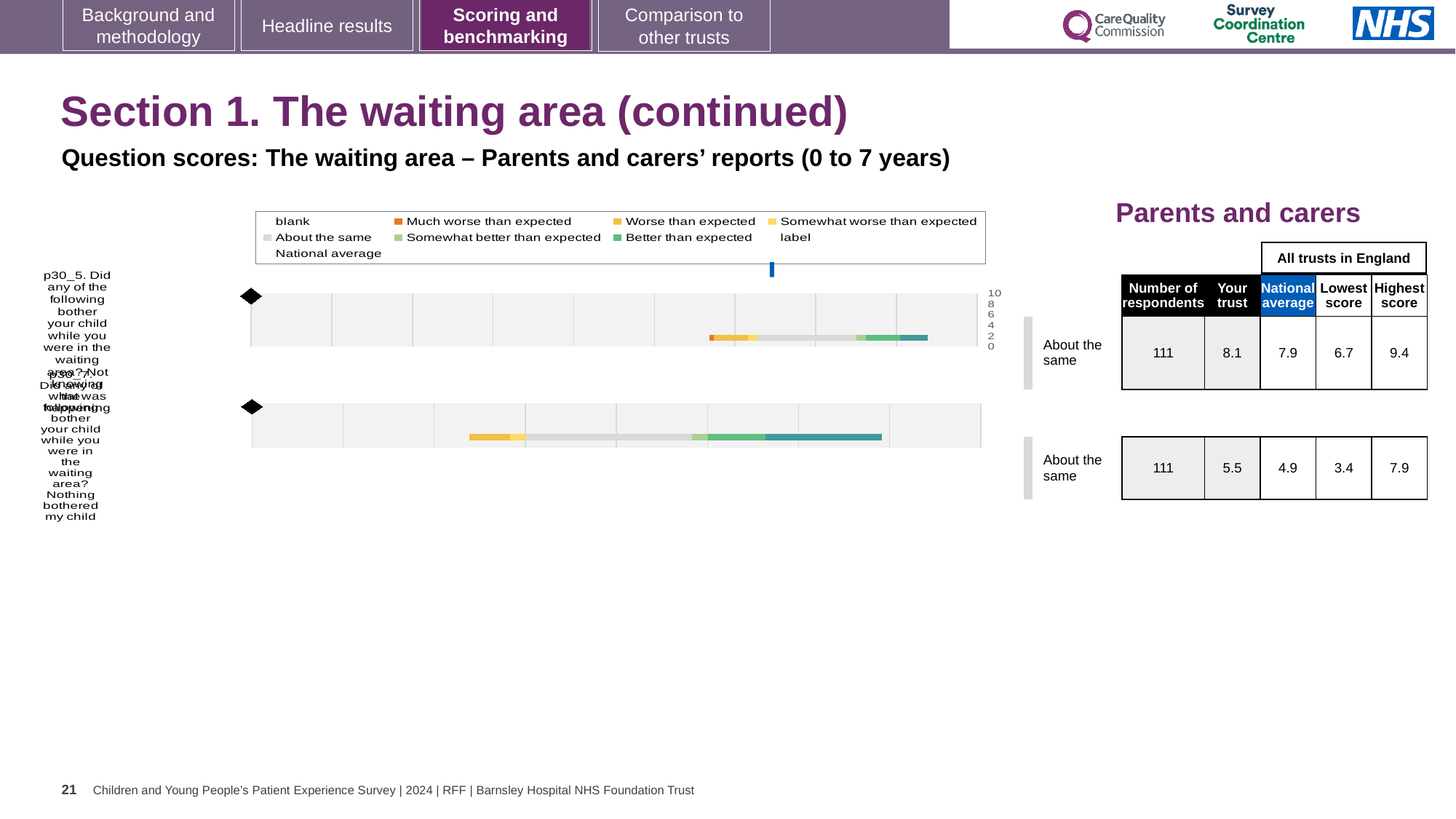
How many respondents answered question p30_5? 111 What is the 'Your trust' score for question p30_7 (Nothing bothered my child)? 5.5 How many question bars are plotted in the chart? 2 How is the trust's result for question p30_7 categorised relative to other trusts? About the same What is the 'Your trust' score for question p30_5 (Did any of the following bother your child while you were in the waiting area? Not knowing what was happening)? 8.1 What kind of chart is used to show the question scores on this slide? bar chart How many entries does the chart legend list? 9 What is the national average score for question p30_5? 7.9 Which question has the higher 'Your trust' score, p30_5 or p30_7? p30_5 What is the lowest score across all trusts in England for question p30_7? 3.4 What is the difference between the highest score (9.4) and the lowest score (6.7) for question p30_5? 2.7 What is the highest value shown on the chart's axis? 10